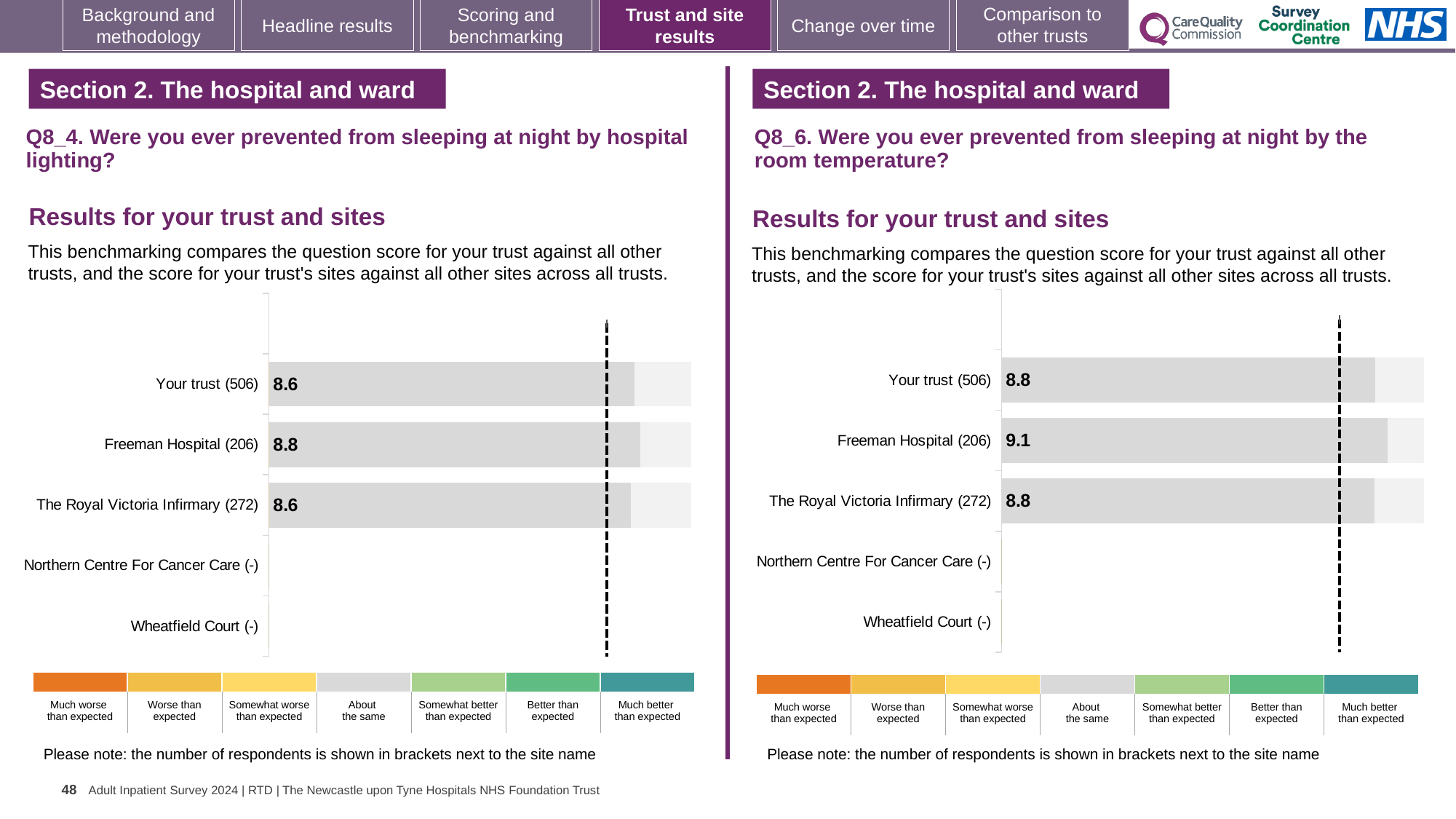
In the Q8_4 chart (hospital lighting), how many respondents are shown in brackets for The Royal Victoria Infirmary? 272 In the Q8_4 chart (hospital lighting), what is the difference between the Freeman Hospital score and The Royal Victoria Infirmary score? 0.2 In the Q8_6 chart (room temperature), what is the difference between the Freeman Hospital score and the Your trust score? 0.3 In the Q8_4 chart (hospital lighting), what is the score for Freeman Hospital (206)? 8.8 How many site/trust rows are listed on the y axis of the Q8_4 chart (hospital lighting)? 5 In the Q8_6 chart (room temperature), what is the score for Freeman Hospital (206)? 9.1 Which is larger: the Your trust score in the Q8_4 chart (hospital lighting) or the Your trust score in the Q8_6 chart (room temperature)? Q8_6 (room temperature) In the Q8_4 chart (hospital lighting), what is the score for Your trust (506)? 8.6 What type of chart is used in the Q8_6 chart (room temperature)? Bar chart In the Q8_4 chart (hospital lighting), which site has the highest score? Freeman Hospital (206) In the Q8_6 chart (room temperature), which site has the highest score? Freeman Hospital (206) In the Q8_6 chart (room temperature), what is the score for The Royal Victoria Infirmary (272)? 8.8